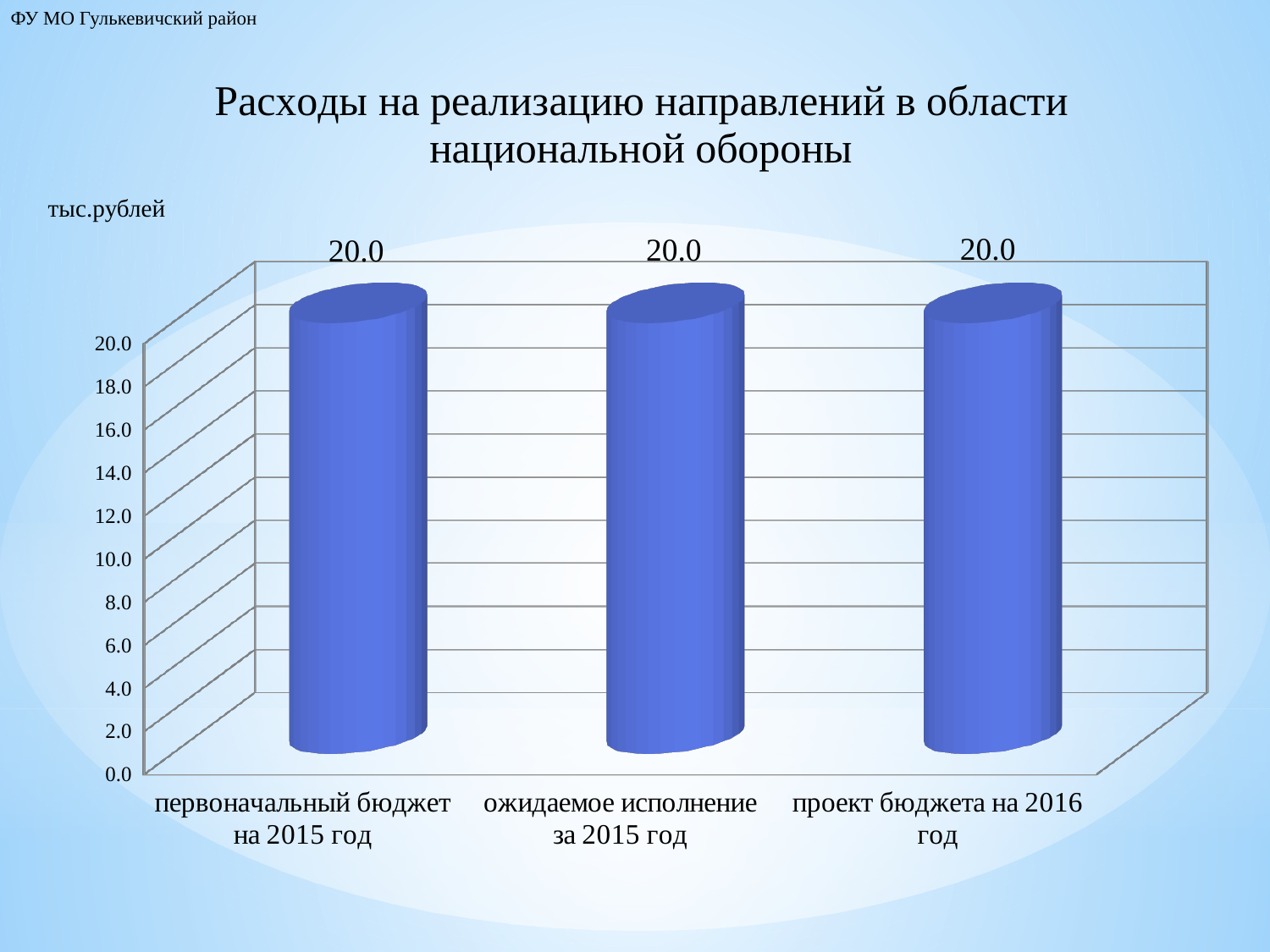
Is the value for "первоначальный бюджет на 2015 год" greater or less than 18.0? greater What is the title of the chart? Расходы на реализацию направлений в области национальной обороны How many categories are shown on the chart? 3 Is the value for "проект бюджета на 2016 год" greater or less than 10.0? greater In what units are the values on the chart expressed? тыс.рублей Do the values rise, fall, or stay the same across the three categories? stay the same What is the value for "первоначальный бюджет на 2015 год"? 20.0 What is the value for "ожидаемое исполнение за 2015 год"? 20.0 What is the value for "проект бюджета на 2016 год"? 20.0 What is the difference between the values for "ожидаемое исполнение за 2015 год" and "первоначальный бюджет на 2015 год"? 0.0 What is the difference between the values for "проект бюджета на 2016 год" and "первоначальный бюджет на 2015 год"? 0.0 What kind of chart is shown on the slide? bar chart